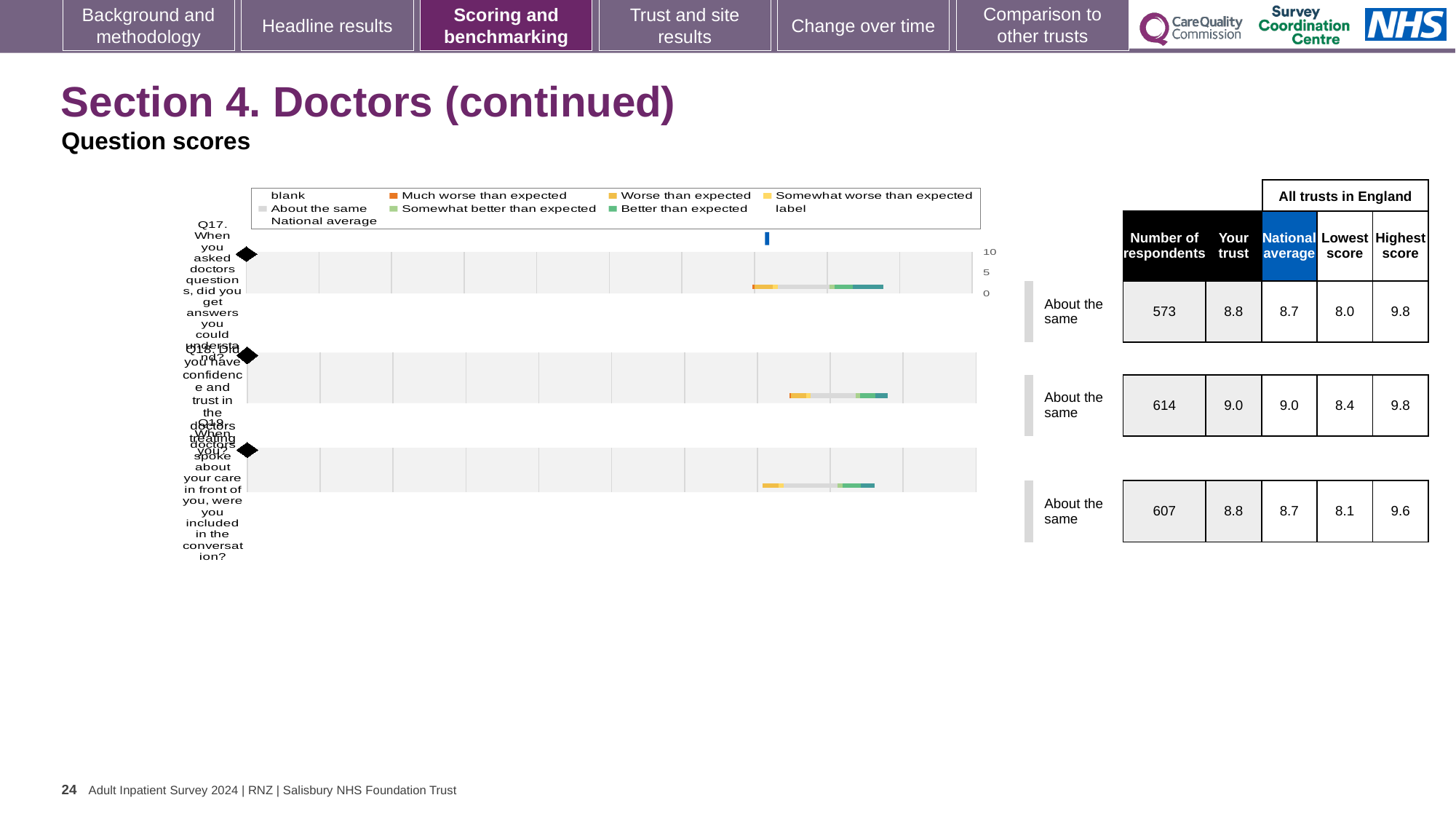
How many respondents answered Q19 (When doctors spoke about your care in front of you, were you included in the conversation)? 607 Is the 'Your trust' score for Q18 greater or less than 5 on the chart axis? greater What is the difference between the highest score (9.8) and the lowest score (8.0) for Q17? 1.8 What colour does the legend use for 'Much worse than expected'? orange Which has the larger 'Your trust' score, Q18 or Q19? Q18 What kind of chart is used to show the question scores for Q17, Q18 and Q19? bar chart Which question has the highest 'Your trust' score? Q18 What is the national average score for Q18 (Did you have confidence and trust in the doctors treating you)? 9.0 What benchmark category is shown for Q17? About the same What is the lowest score among all trusts in England for Q19? 8.1 What is the 'Your trust' score for Q17 (When you asked doctors questions, did you get answers you could understand)? 8.8 How many questions (rows) are plotted in the chart? 3